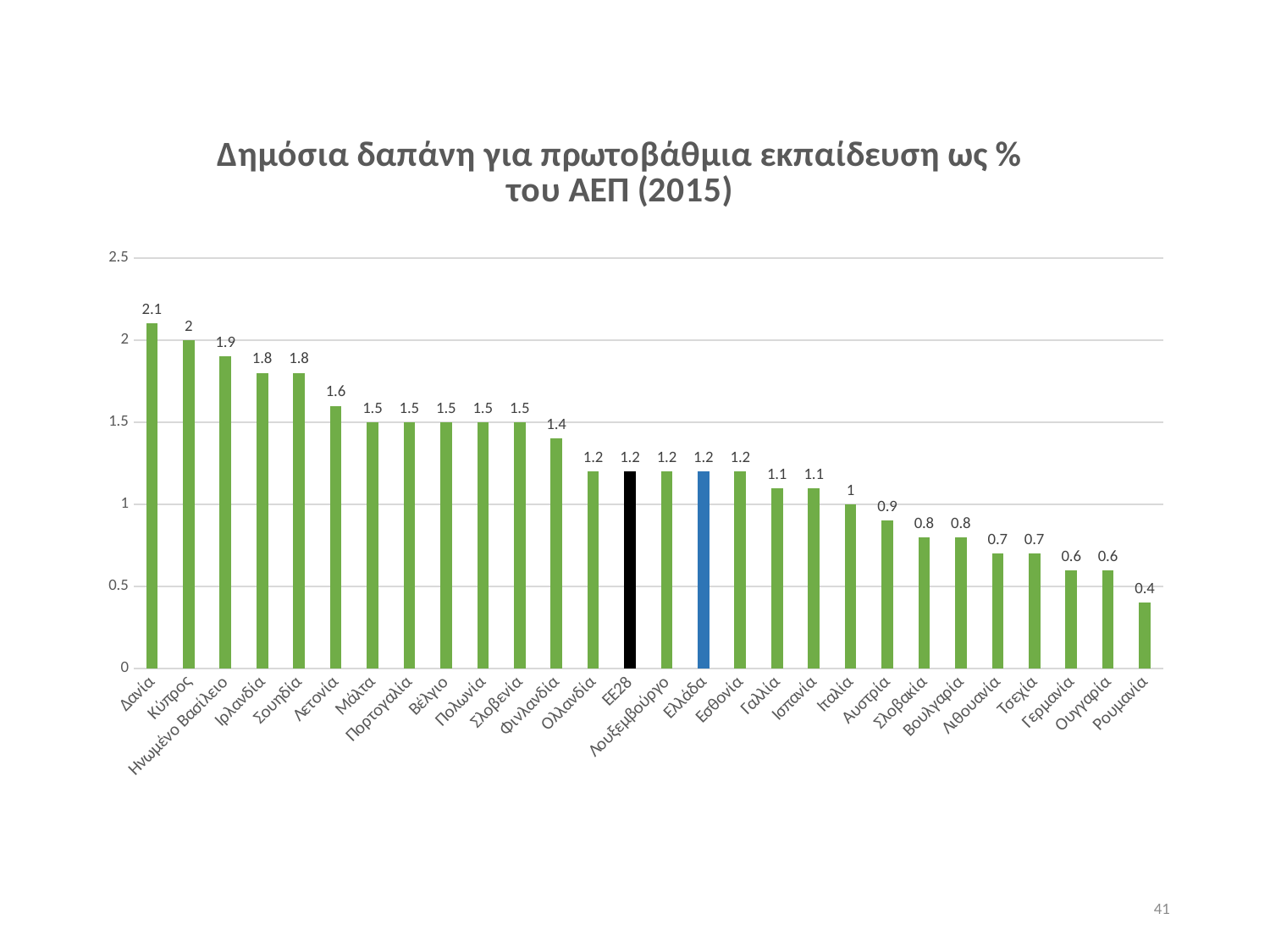
Which is larger, the value for Λετονία or the value for Γαλλία? Λετονία What is the value for Δανία? 2.1 What kind of chart is shown on the slide? Bar chart Do the values rise or fall from left to right along the x axis? Fall How many categories are shown on the x axis? 28 What is the value for Ρουμανία? 0.4 What is the difference between the values for Δανία and Ρουμανία? 1.7 Which category has the highest value? Δανία What is the value for Ελλάδα? 1.2 What is the value for ΕΕ28? 1.2 What is the difference between the values for Κύπρος and Ελλάδα? 0.8 Which category has the lowest value? Ρουμανία